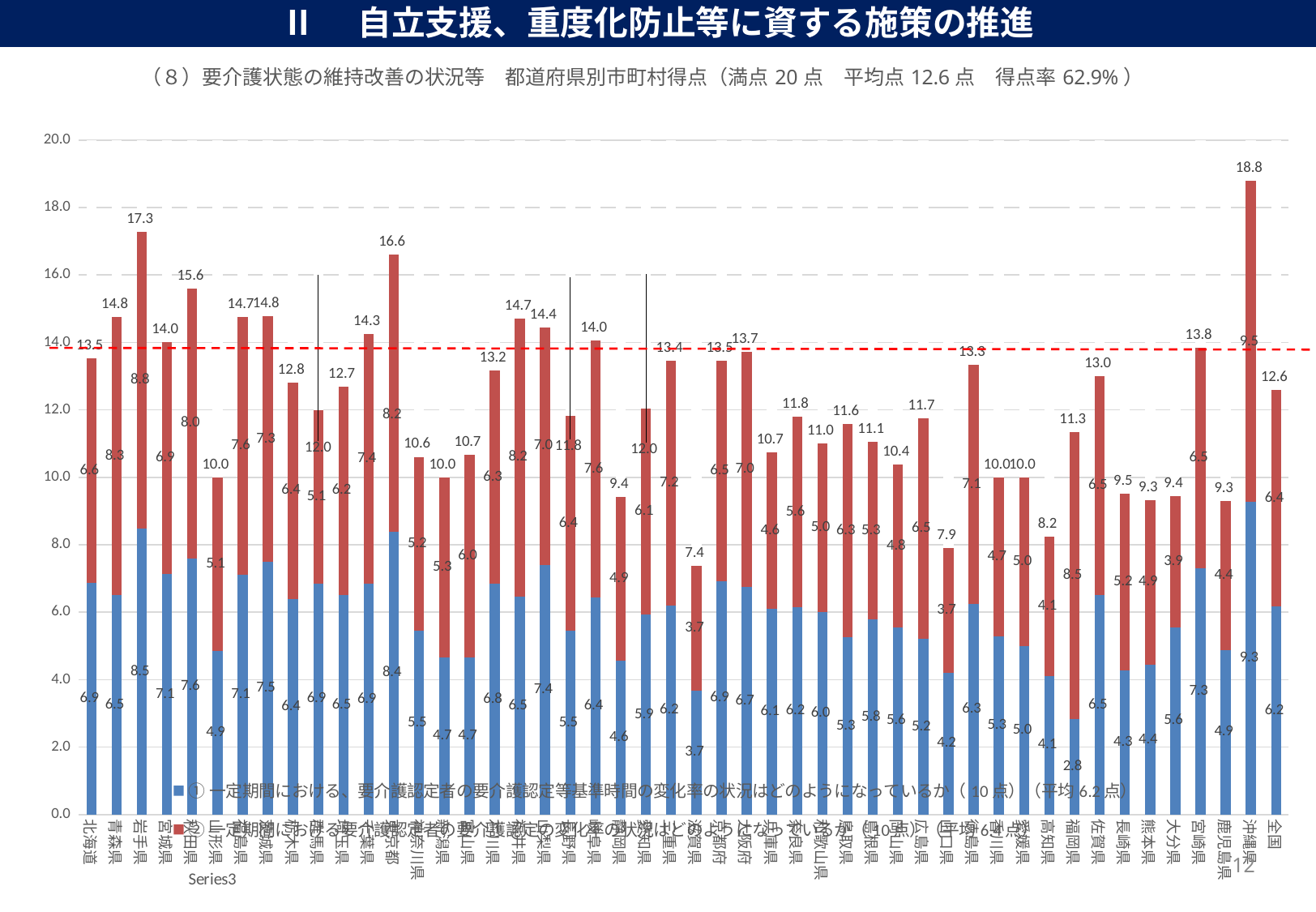
Which prefecture has the lowest total score? 滋賀県 What is the difference between the total scores of 沖縄県 and 岩手県? 1.5 What kind of chart is shown on the slide? stacked bar chart How many series does the legend list? 3 Which prefecture has the highest total score? 沖縄県 What is the total score for 全国? 12.6 Which has the higher total score, 東京都 or 秋田県? 東京都 What is the total of the stacked bar for 福岡県 (2.8 + 8.5)? 11.3 Is the total score for 福岡県 greater or less than 10.0? greater What is the value of the blue (①) segment for 沖縄県? 9.3 How many bars (categories) are plotted on the x axis? 48 What is the total score for 北海道? 13.5